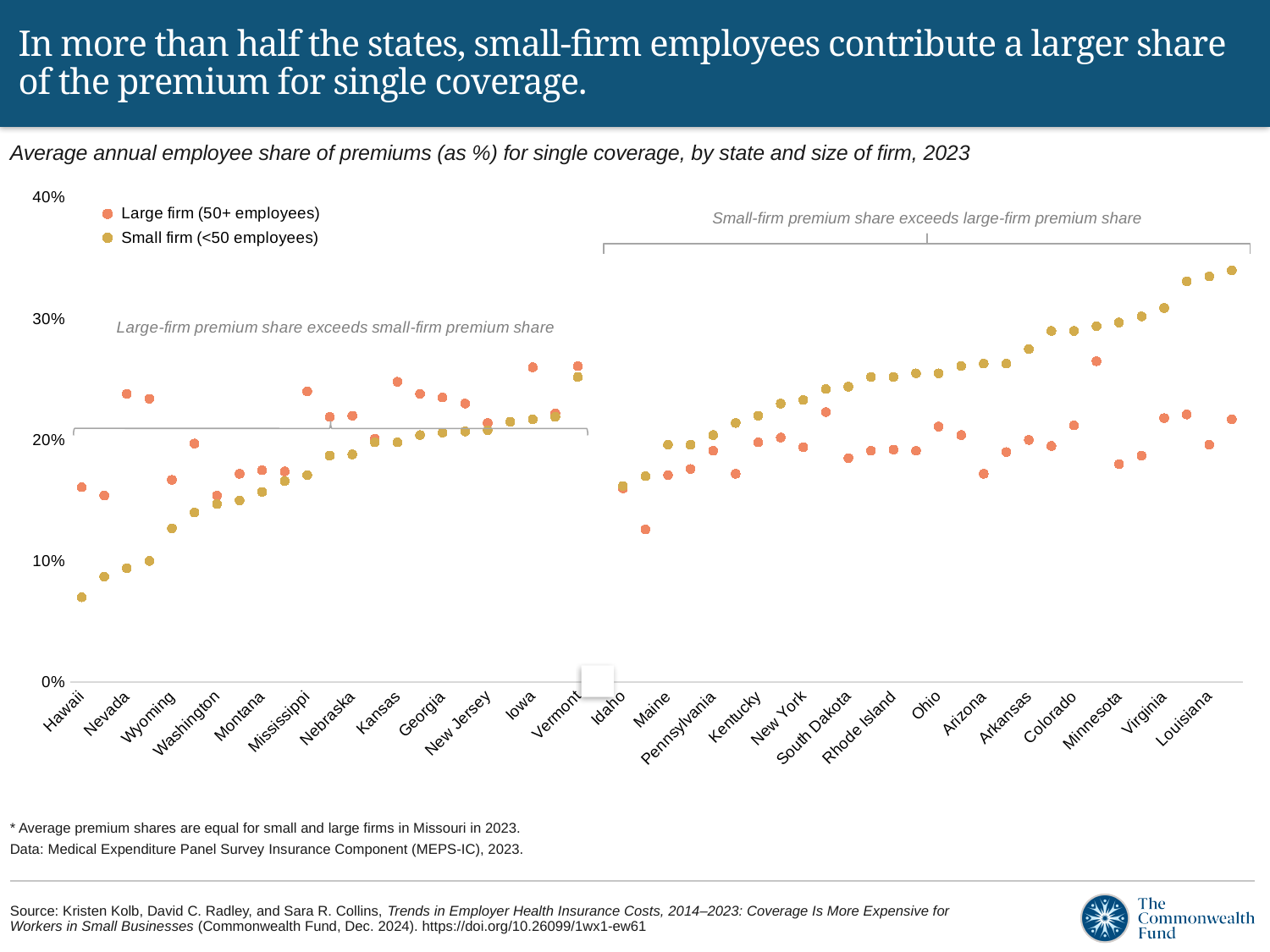
Is the small-firm value for Hawaii greater or less than 10%? less Is the large-firm value for Vermont greater or less than 20%? greater For Louisiana, which is larger: the large-firm share or the small-firm share? Small-firm share Which series is shown in orange-red dots? Large firm (50+ employees) What is the highest value shown on the vertical axis? 40% Is the large-firm value for Hawaii greater or less than 20%? less What kind of chart is shown on the slide? Scatter (dot) chart For Hawaii, which is larger: the large-firm share or the small-firm share? Large-firm share Which state has the lowest small-firm premium share? Hawaii How many series does the legend list? 2